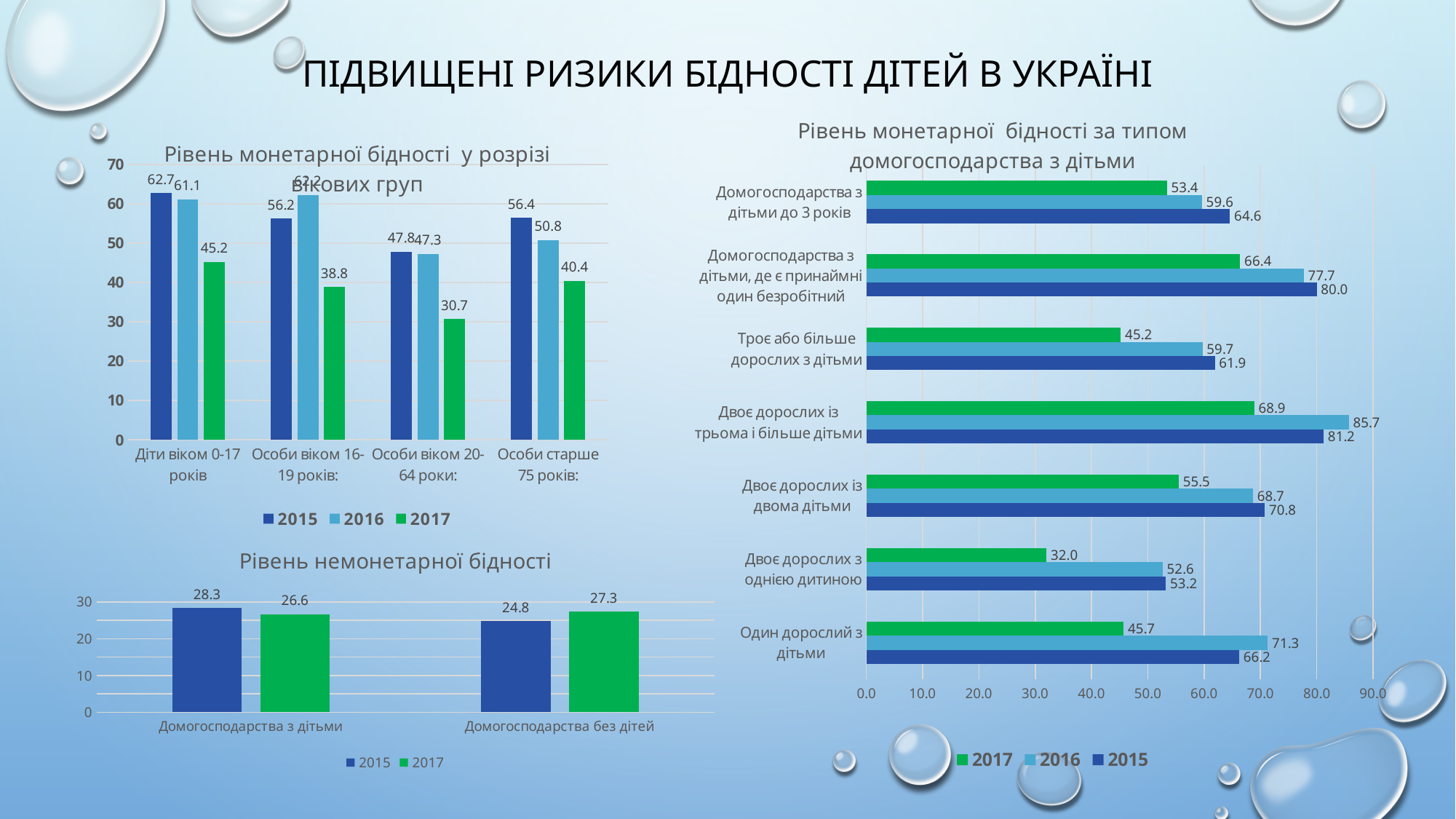
In the chart 'Рівень немонетарної бідності', what is the 2015 value for 'Домогосподарства без дітей'? 24.8 In the chart 'Рівень немонетарної бідності', which is larger for 'Домогосподарства з дітьми': the 2015 value or the 2017 value? 2015 In the chart 'Рівень немонетарної бідності', how many categories are shown on the x axis? 2 In the chart 'Рівень монетарної бідності у розрізі вікових груп', how many series does the legend list? 3 In the chart 'Рівень монетарної бідності у розрізі вікових груп', what is the 2017 value for 'Діти віком 0-17 років'? 45.2 In the chart 'Рівень монетарної бідності за типом домогосподарства з дітьми', how many household types are listed? 7 What kind of chart is 'Рівень монетарної бідності за типом домогосподарства з дітьми'? Bar chart In the chart 'Рівень монетарної бідності за типом домогосподарства з дітьми', what is the 2016 value for 'Один дорослий з дітьми'? 71.3 In the chart 'Рівень монетарної бідності за типом домогосподарства з дітьми', which household type has the lowest 2017 value? Двоє дорослих з однією дитиною In the chart 'Рівень монетарної бідності за типом домогосподарства з дітьми', which household type has the highest 2016 value? Двоє дорослих із трьома і більше дітьми In the chart 'Рівень монетарної бідності у розрізі вікових груп', what is the difference between the 2015 and 2017 values for 'Особи віком 16-19 років'? 17.4 In the chart 'Рівень монетарної бідності у розрізі вікових груп', which age group has the lowest 2017 value? Особи віком 20-64 роки